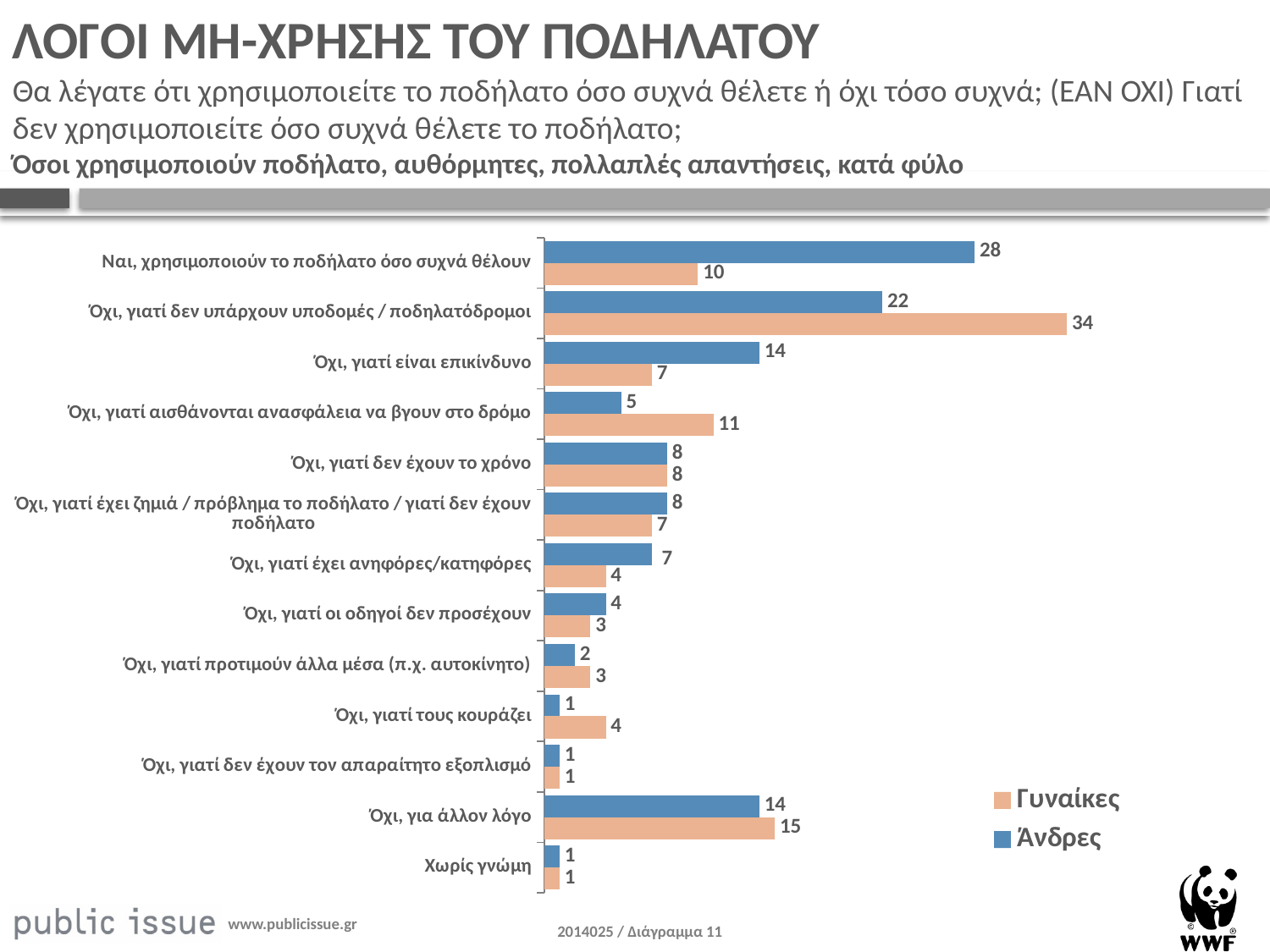
Which is larger for 'Όχι, γιατί είναι επικίνδυνο': the value for Άνδρες or for Γυναίκες? Άνδρες What is the value for Γυναίκες in the category 'Όχι, γιατί αισθάνονται ανασφάλεια να βγουν στο δρόμο'? 11 Which category has the highest value for Άνδρες? Ναι, χρησιμοποιούν το ποδήλατο όσο συχνά θέλουν What type of chart is shown on the slide? bar chart Which colour represents the Γυναίκες series in the chart? orange What is the difference between the Γυναίκες and Άνδρες values for 'Όχι, γιατί δεν υπάρχουν υποδομές / ποδηλατόδρομοι'? 12 What is the value for Γυναίκες in the category 'Όχι, γιατί δεν υπάρχουν υποδομές / ποδηλατόδρομοι'? 34 What is the value for Άνδρες in the category 'Ναι, χρησιμοποιούν το ποδήλατο όσο συχνά θέλουν'? 28 How many series does the legend list? 2 Which category has the highest value for Γυναίκες? Όχι, γιατί δεν υπάρχουν υποδομές / ποδηλατόδρομοι What is the difference between the Άνδρες and Γυναίκες values for 'Ναι, χρησιμοποιούν το ποδήλατο όσο συχνά θέλουν'? 18 How many categories are plotted on the chart? 13